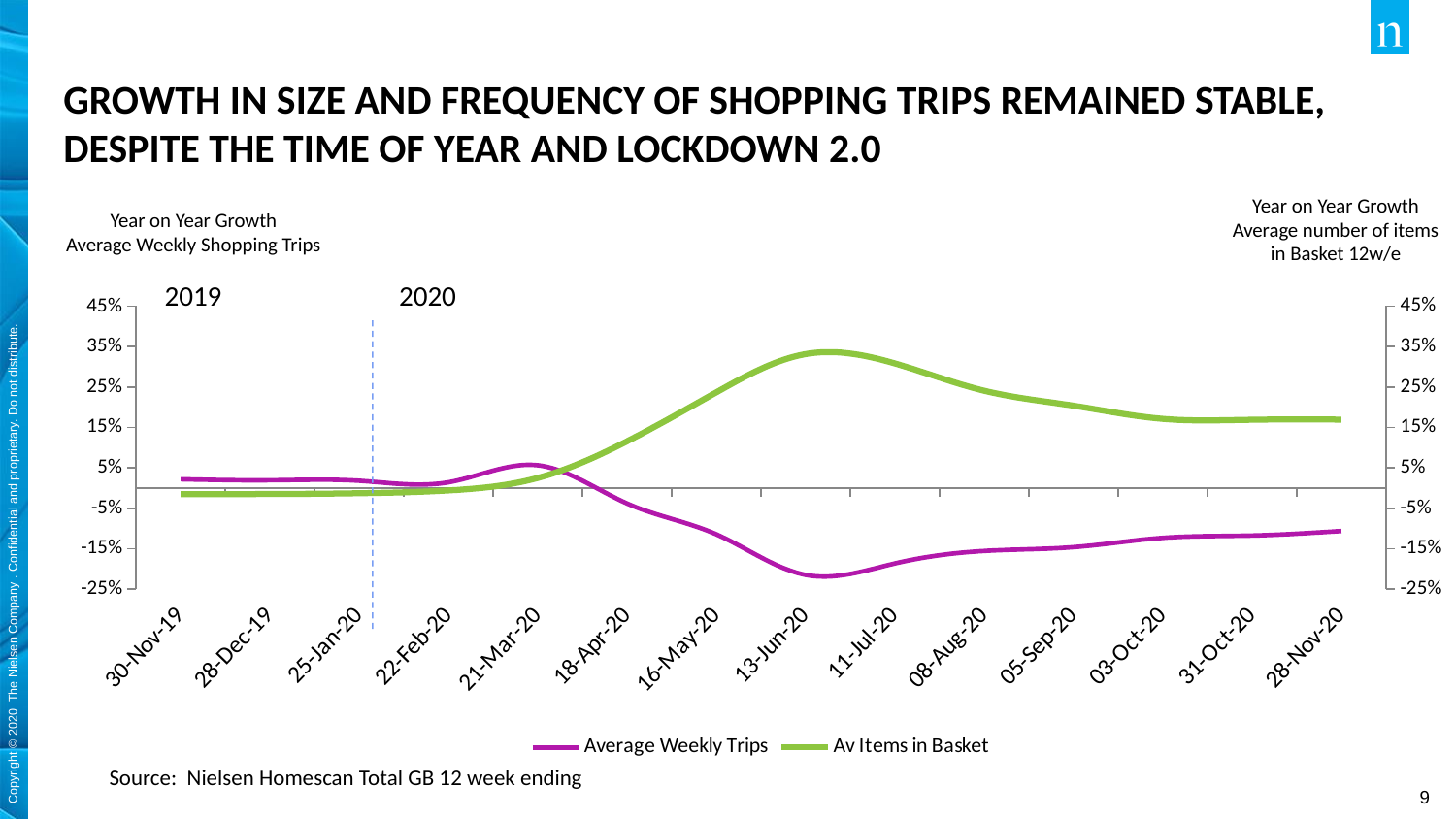
Is the value for Av Items in Basket at 13-Jun-20 greater or less than 25%? greater At 28-Nov-20, which series has the higher value, Average Weekly Trips or Av Items in Basket? Av Items in Basket How many dates are labelled along the x axis? 14 Does the Av Items in Basket line rise or fall between 13-Jun-20 and 28-Nov-20? Fall Does the Average Weekly Trips line rise or fall between 13-Jun-20 and 28-Nov-20? Rise What kind of chart is shown on the slide? Line chart What is the first date labelled on the x axis? 30-Nov-19 Which two series are listed in the legend? Average Weekly Trips and Av Items in Basket Is the value for Average Weekly Trips at 28-Nov-20 greater or less than -5%? less Is the value for Av Items in Basket at 28-Nov-20 greater or less than 5%? greater How many series does the legend list? 2